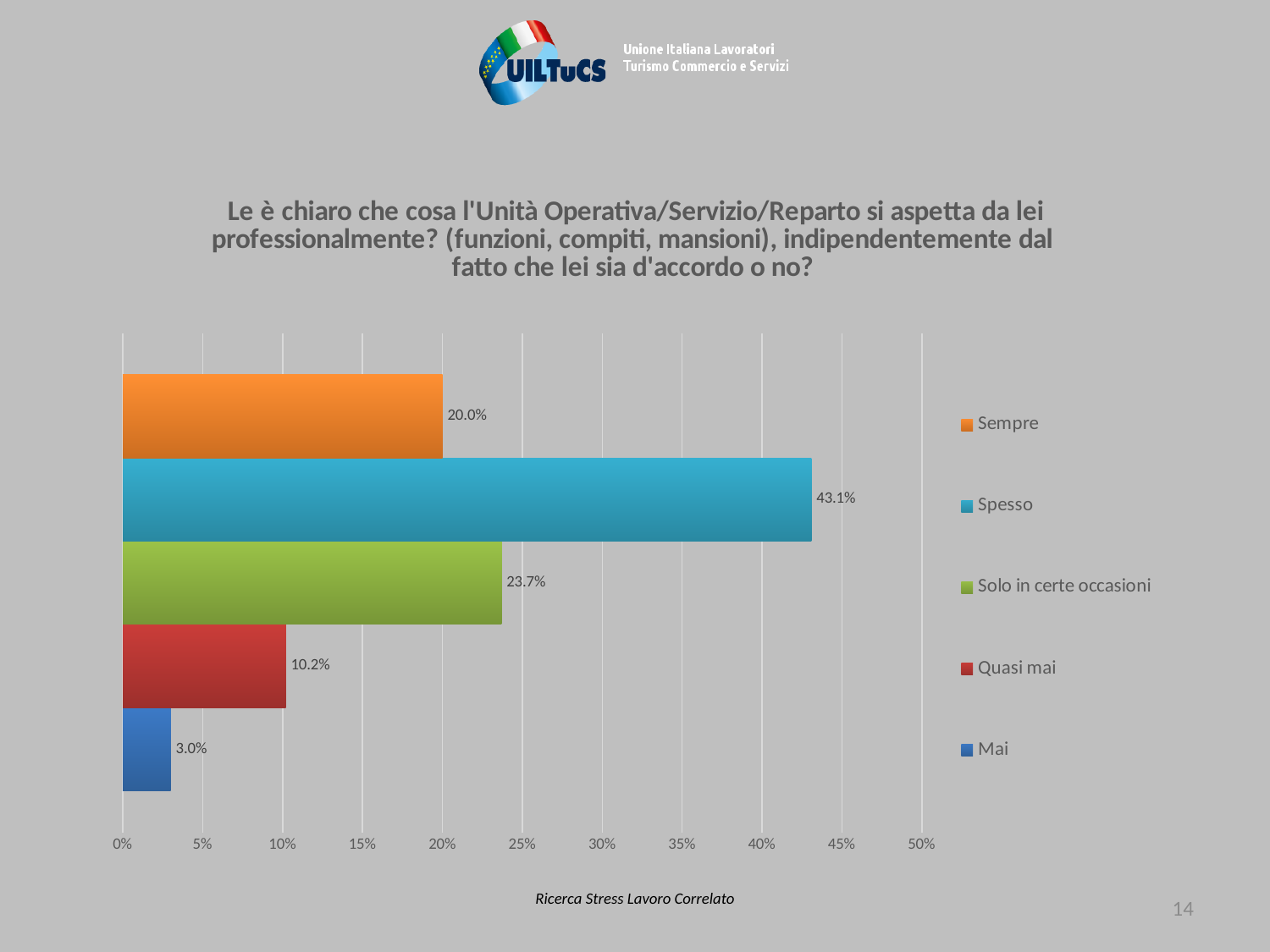
How many categories are shown in the chart? 5 Which category has the lowest value? Mai What is the value for Solo in certe occasioni? 23.7% Which category has the highest value? Spesso What is the value for Quasi mai? 10.2% Is the value for Quasi mai greater or less than 15%? less What is the difference between the values for Spesso and Sempre? 23.1% What kind of chart is shown on the slide? bar chart What is the value for Spesso? 43.1% What colour is the bar for Spesso? blue Which is larger, the value for Sempre or the value for Solo in certe occasioni? Solo in certe occasioni What is the value for Mai? 3.0%